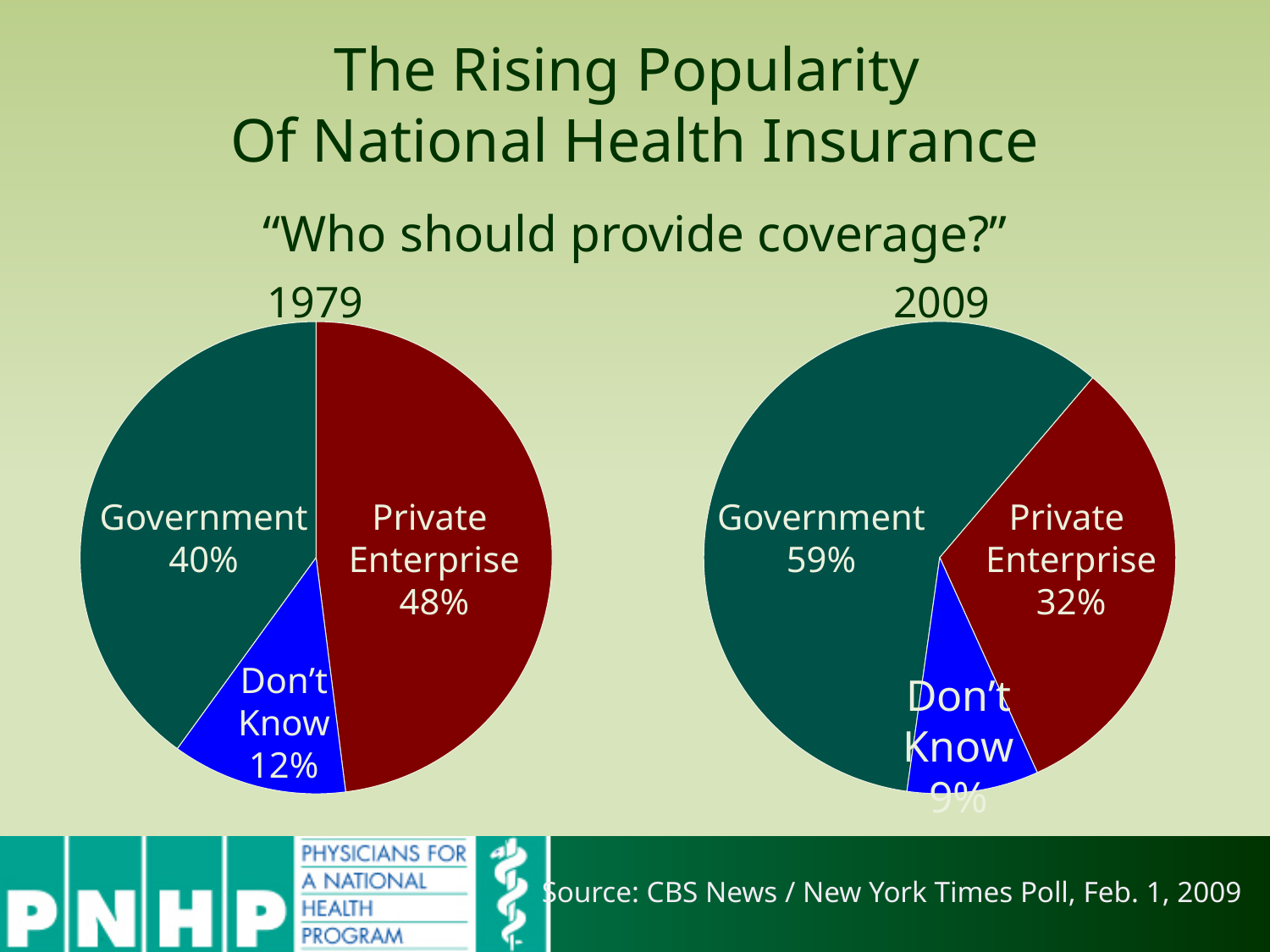
In the 1979 pie chart, which response has the largest slice? Private Enterprise In the 2009 pie chart, which is larger: the Government slice or the Private Enterprise slice? Government In the 2009 pie chart, what share of respondents said Government should provide coverage? 59% How many slices does the 1979 pie chart have? 3 In the 1979 pie chart, what percentage answered Don't Know? 12% In the 2009 pie chart, what share of respondents said Private Enterprise should provide coverage? 32% What question do the two pie charts on the slide answer? "Who should provide coverage?" What is the difference between the Government share in 2009 and the Government share in 1979? 19 percentage points In the 1979 pie chart, what is the difference between the Private Enterprise share and the Don't Know share? 36 percentage points In the 1979 pie chart, what share of respondents said Government should provide coverage? 40% What type of chart is used to show the 1979 and 2009 responses? Pie chart In the 2009 pie chart, which response has the smallest slice? Don't Know